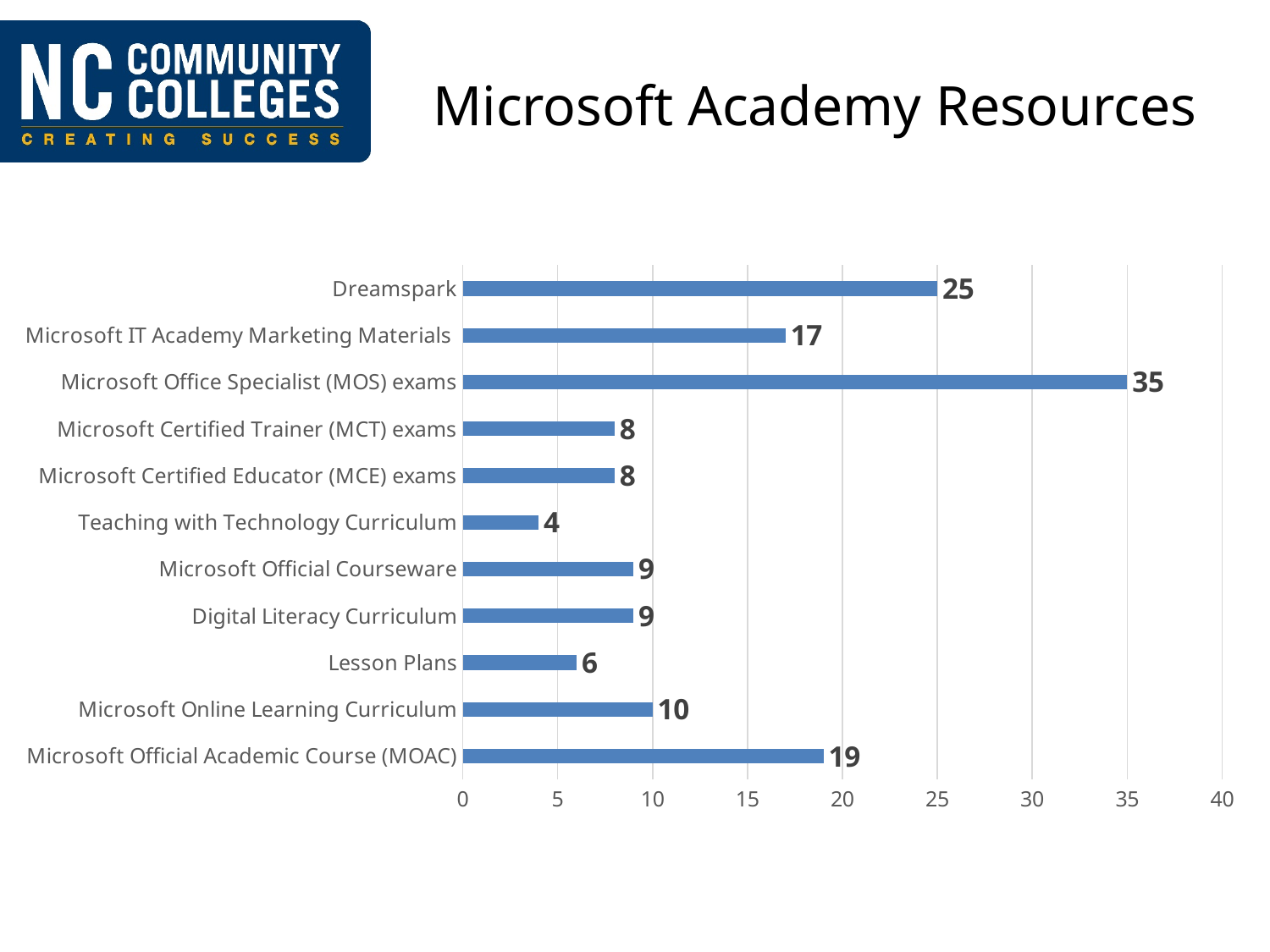
How many categories are shown in the chart? 11 What is the value for Dreamspark? 25 What is the value for Teaching with Technology Curriculum? 4 What is the value for Microsoft Official Academic Course (MOAC)? 19 What kind of chart is shown on the slide? bar chart What is the title of the slide? Microsoft Academy Resources Which category has the highest value? Microsoft Office Specialist (MOS) exams Which is larger, the value for Microsoft Online Learning Curriculum or the value for Lesson Plans? Microsoft Online Learning Curriculum What is the difference between the values for Microsoft IT Academy Marketing Materials and Lesson Plans? 11 Is the value for Microsoft Official Academic Course (MOAC) greater or less than 15? greater What is the difference between the values for Microsoft Office Specialist (MOS) exams and Dreamspark? 10 Which category has the lowest value? Teaching with Technology Curriculum